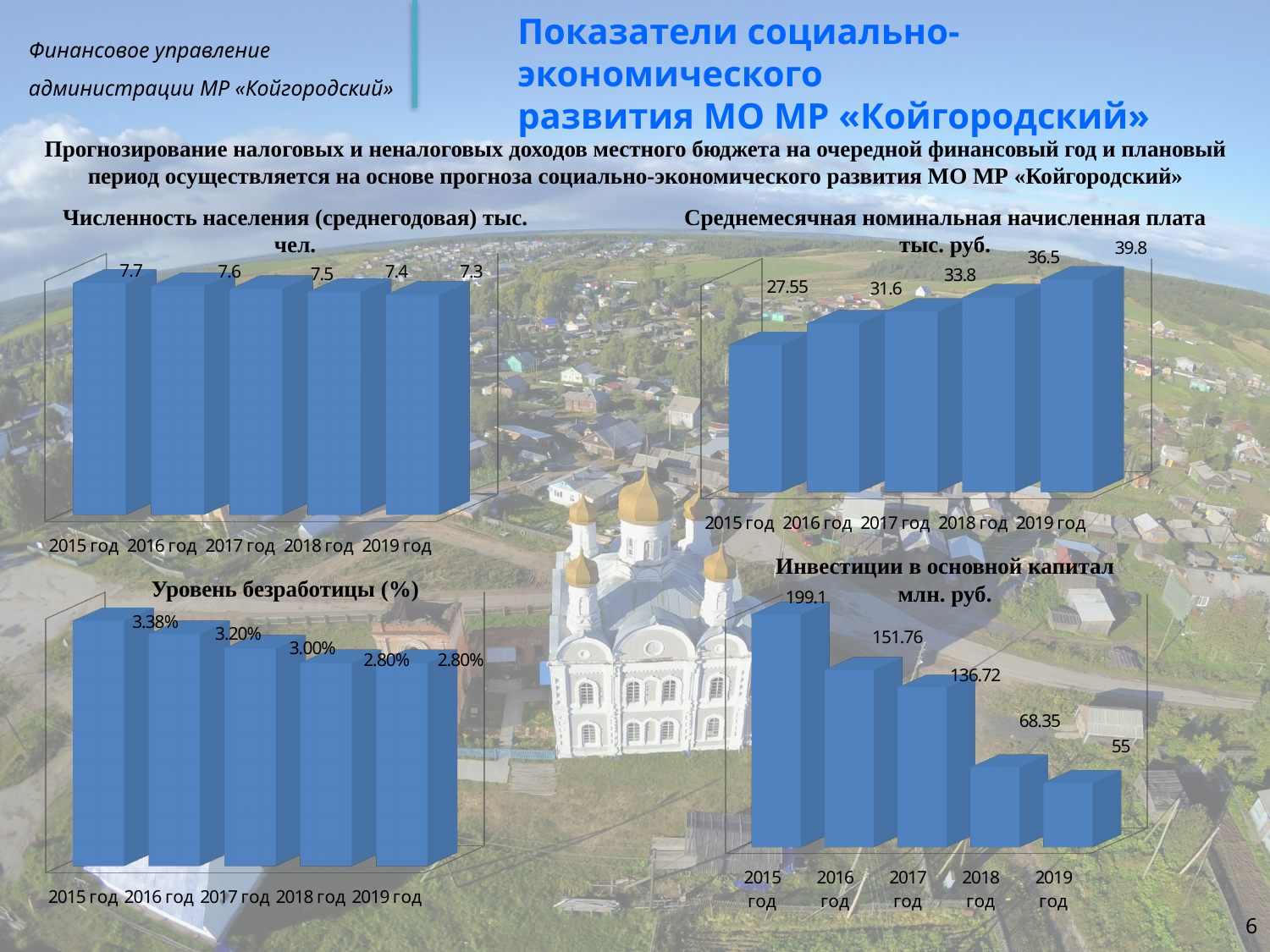
In the chart 'Среднемесячная номинальная начисленная плата тыс. руб.', what is the difference between the values for 2019 год and 2015 год? 12.25 What type of chart is 'Уровень безработицы (%)'? bar chart In the chart 'Среднемесячная номинальная начисленная плата тыс. руб.', which year has the highest value? 2019 год In the chart 'Уровень безработицы (%)', what is the value for 2016 год? 3.20% In the chart 'Среднемесячная номинальная начисленная плата тыс. руб.', what is the value for 2017 год? 33.8 In the chart 'Инвестиции в основной капитал млн. руб.', which is larger, the value for 2016 год or 2017 год? 2016 год In the chart 'Численность населения (среднегодовая) тыс. чел.', do the values rise or fall from 2015 год to 2019 год? fall In the chart 'Численность населения (среднегодовая) тыс. чел.', what is the value for 2015 год? 7.7 In the chart 'Инвестиции в основной капитал млн. руб.', which year has the lowest value? 2019 год How many years are shown in the chart 'Инвестиции в основной капитал млн. руб.'? 5 In the chart 'Уровень безработицы (%)', which year has the highest value? 2015 год In the chart 'Инвестиции в основной капитал млн. руб.', what is the value for 2018 год? 68.35